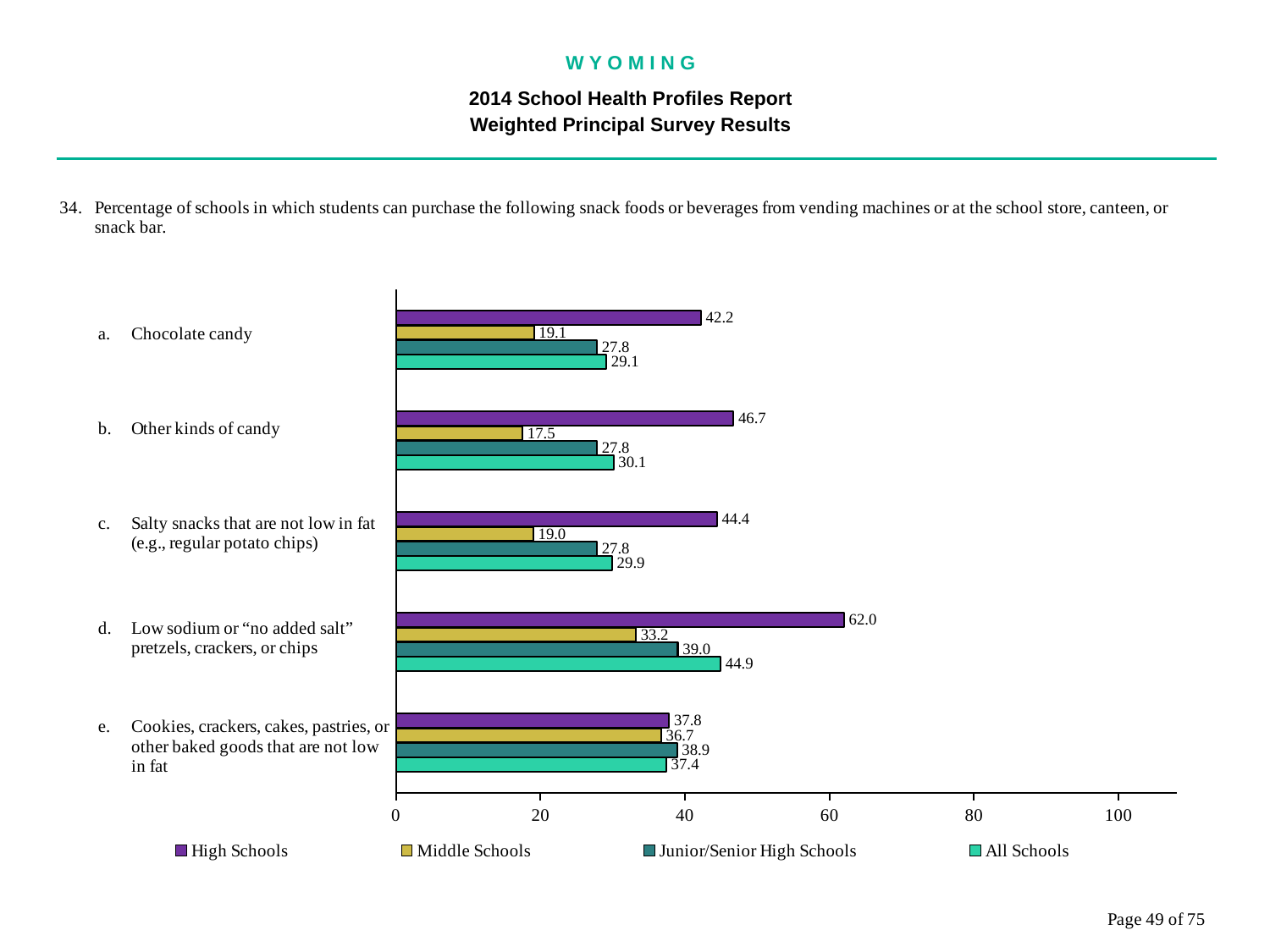
How many categories are shown in the chart? 5 What is the value for High Schools for Chocolate candy? 42.2 Which category has the lowest value for Middle Schools? Other kinds of candy What kind of chart is shown on the slide? Bar chart What is the difference between the High Schools and Middle Schools values for Salty snacks that are not low in fat? 25.4 Which is larger for Chocolate candy: the Junior/Senior High Schools value or the All Schools value? All Schools Is the High Schools value for Low sodium or "no added salt" pretzels, crackers, or chips greater or less than 60? greater What is the value for Junior/Senior High Schools for Cookies, crackers, cakes, pastries, or other baked goods that are not low in fat? 38.9 Which category has the highest value for High Schools? Low sodium or "no added salt" pretzels, crackers, or chips What is the value for All Schools for Low sodium or "no added salt" pretzels, crackers, or chips? 44.9 What is the value for Middle Schools for Other kinds of candy? 17.5 How many series does the legend list? 4